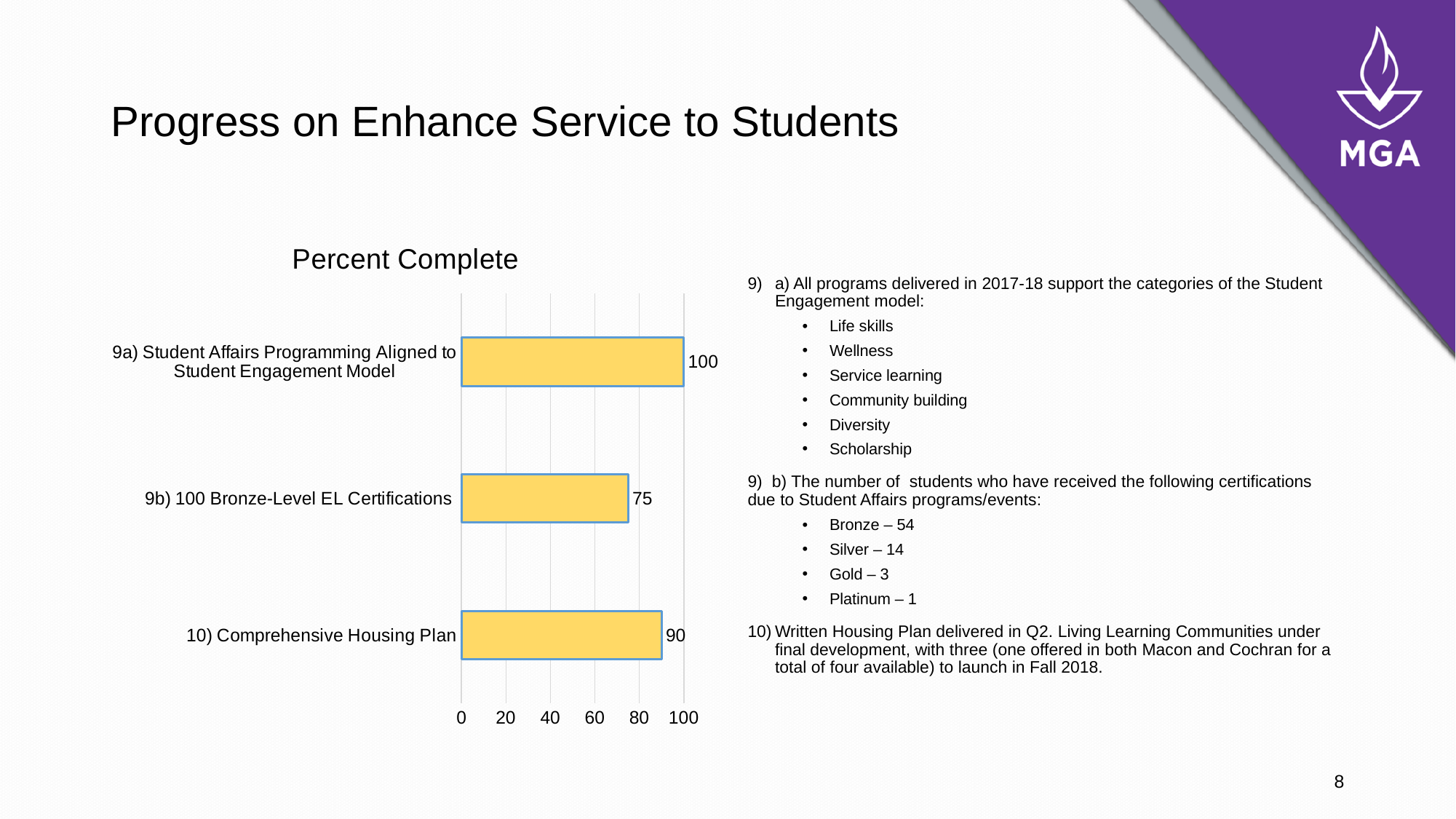
What is the value for 10) Comprehensive Housing Plan? 90 How many categories are shown in the chart? 3 What is the title of the chart? Percent Complete Is the value for 9b) 100 Bronze-Level EL Certifications greater or less than 80? less Which is larger, the value for 10) Comprehensive Housing Plan or the value for 9b) 100 Bronze-Level EL Certifications? 10) Comprehensive Housing Plan What is the value for 9b) 100 Bronze-Level EL Certifications? 75 Which category has the highest percent complete? 9a) Student Affairs Programming Aligned to Student Engagement Model What is the difference between the values for 9a) Student Affairs Programming Aligned to Student Engagement Model and 9b) 100 Bronze-Level EL Certifications? 25 What is the difference between the values for 10) Comprehensive Housing Plan and 9b) 100 Bronze-Level EL Certifications? 15 What kind of chart is shown on the slide? bar chart What is the value for 9a) Student Affairs Programming Aligned to Student Engagement Model? 100 Which category has the lowest percent complete? 9b) 100 Bronze-Level EL Certifications